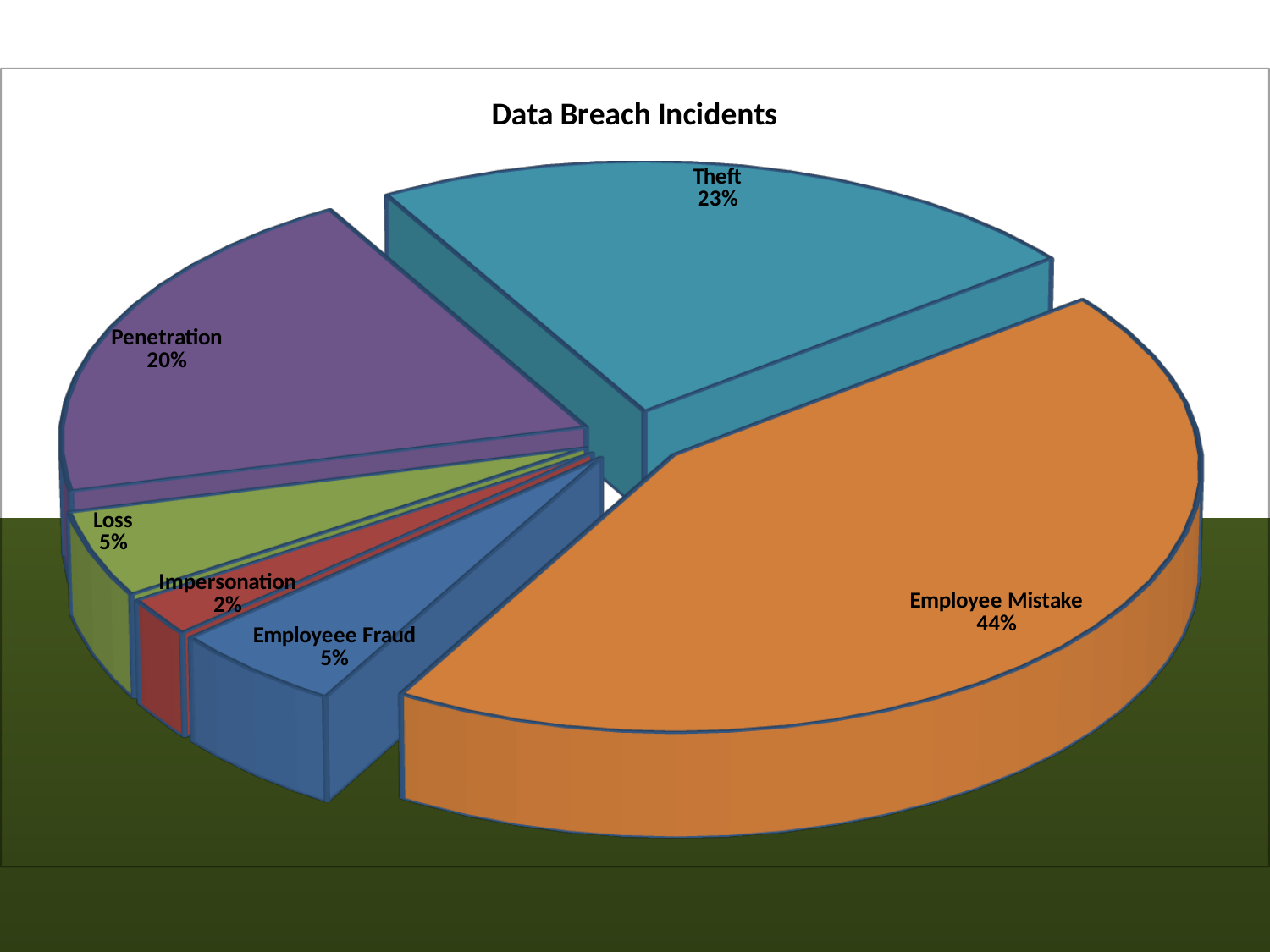
How many categories are shown in the pie chart? 6 What share of data breach incidents is attributed to Employee Mistake? 44% What percentage is shown for Theft? 23% What percentage is shown for Impersonation? 2% What kind of chart is shown on the slide? pie chart What is the title of the chart? Data Breach Incidents What colour is the Employee Mistake slice? orange Which category has the smallest slice of the pie? Impersonation Which category has the largest slice of the pie? Employee Mistake Which is larger, the share for Theft or the share for Penetration? Theft What is the difference in percentage points between Employee Mistake and Theft? 21% What percentage is shown for Penetration? 20%